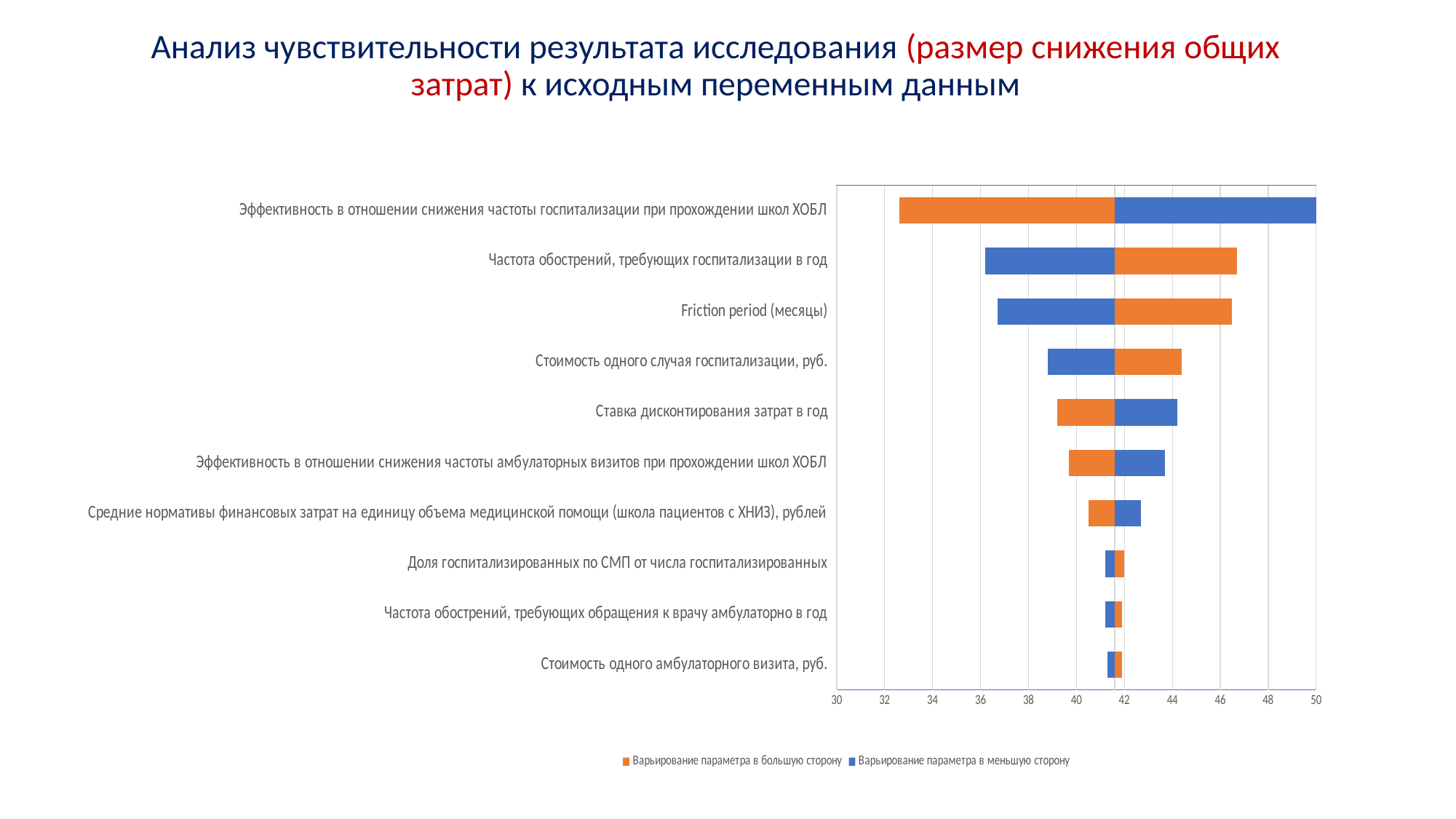
Is the left end of the blue bar for 'Частота обострений, требующих госпитализации в год' greater or less than 38? less Which colour represents 'Варьирование параметра в меньшую сторону' in the legend? blue Is the left end of the blue bar for 'Стоимость одного случая госпитализации, руб.' greater or less than 40? less Is the right end of the orange bar for 'Friction period (месяцы)' greater or less than 46? greater How many categories (input parameters) are listed on the vertical axis of the chart? 10 How many series does the chart legend list? 2 Which colour represents 'Варьирование параметра в большую сторону' in the legend? orange What kind of chart is shown on the slide? bar chart Which category has the widest total bar (largest sensitivity range)? Эффективность в отношении снижения частоты госпитализации при прохождении школ ХОБЛ